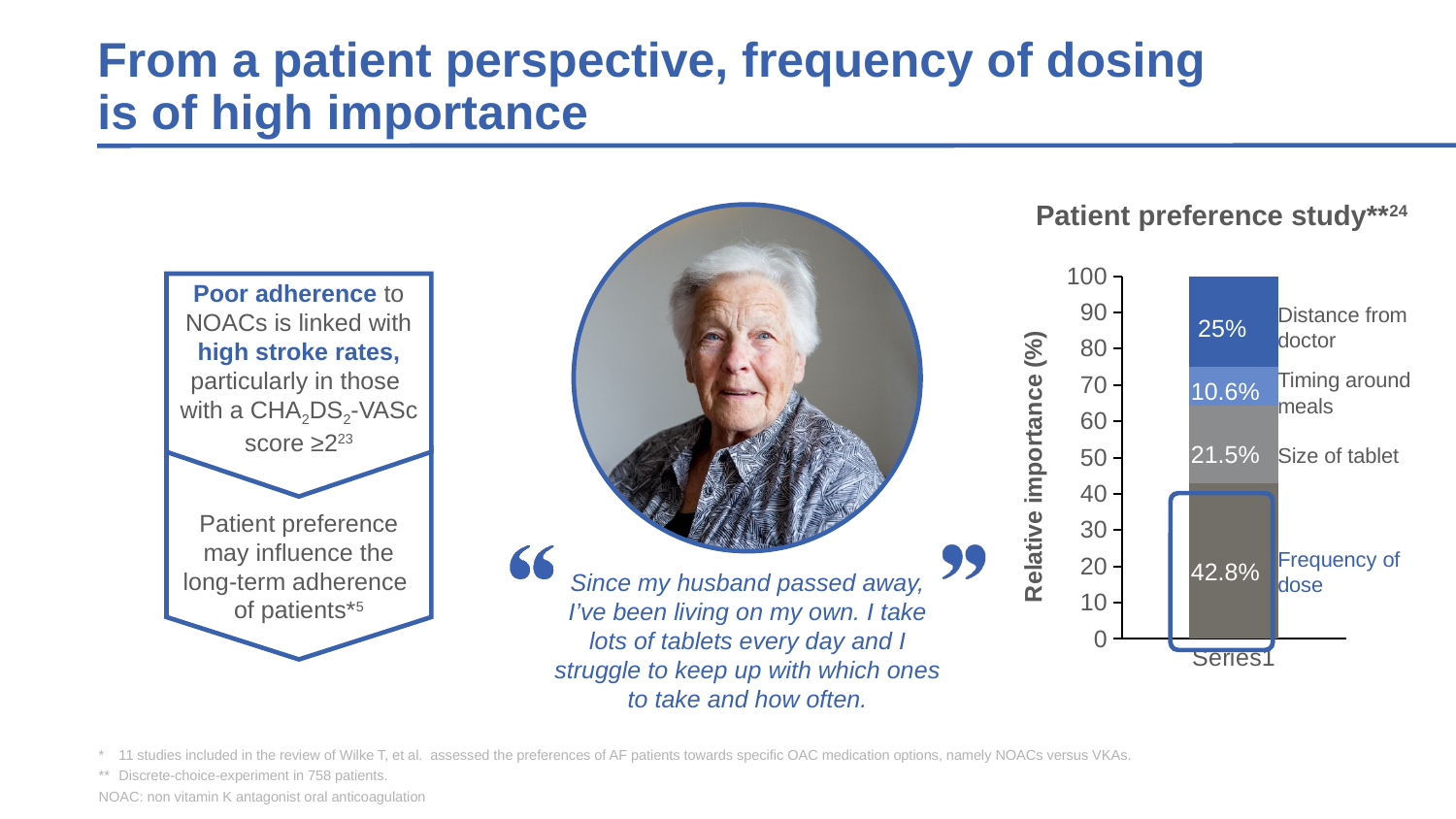
What is the relative importance of Frequency of dose in the Patient preference study chart? 42.8% What is the relative importance of Size of tablet in the Patient preference study chart? 21.5% What is the relative importance of Distance from doctor in the Patient preference study chart? 25% What is the difference in relative importance between Frequency of dose and Distance from doctor? 17.8% What is the label of the y axis in the Patient preference study chart? Relative importance (%) What is the relative importance of Timing around meals in the Patient preference study chart? 10.6% What is the difference in relative importance between Size of tablet and Timing around meals? 10.9% What type of chart is used for the Patient preference study? Stacked bar chart Which attribute has the highest relative importance in the Patient preference study chart? Frequency of dose Which has a larger relative importance, Distance from doctor or Size of tablet? Distance from doctor How many segments make up the stacked bar in the Patient preference study chart? 4 Which attribute has the lowest relative importance in the Patient preference study chart? Timing around meals